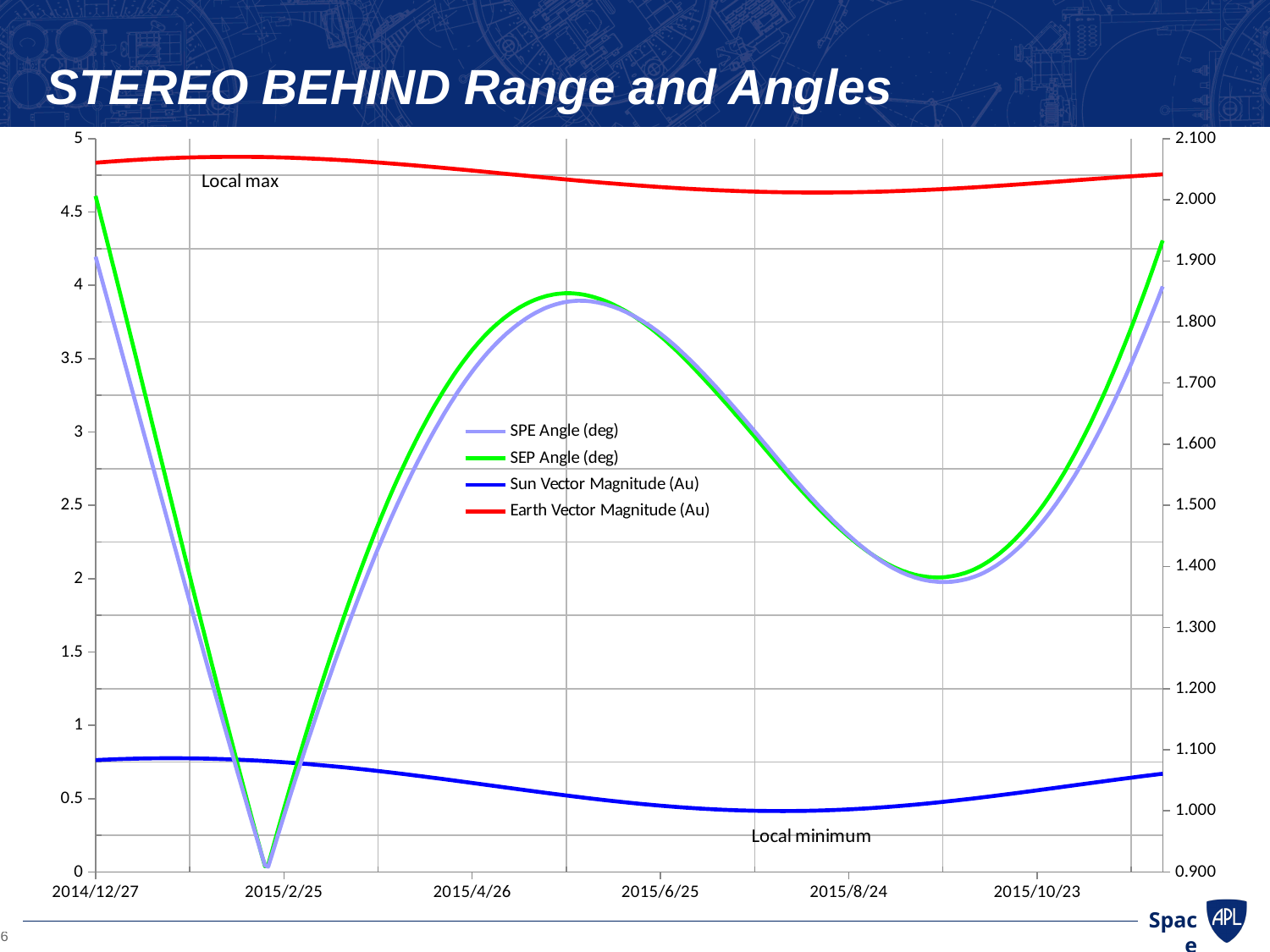
Is the value of SEP Angle (deg) at 2015/4/26 greater or less than 2.5? greater Is the value of Sun Vector Magnitude (Au) at 2015/8/24 greater or less than 1.100? less What is the title of the chart? STEREO BEHIND Range and Angles At 2015/6/25, which is larger: Earth Vector Magnitude (Au) or Sun Vector Magnitude (Au)? Earth Vector Magnitude (Au) Is the value of Earth Vector Magnitude (Au) at 2014/12/27 greater or less than 2.000? greater What annotation label is placed near the lowest point of the Sun Vector Magnitude (Au) line? Local minimum How many date labels are shown on the x axis? 6 How many series does the legend list? 4 Does the Earth Vector Magnitude (Au) line rise or fall between 2015/2/25 and 2015/8/24? fall What kind of chart is shown on the slide? line chart